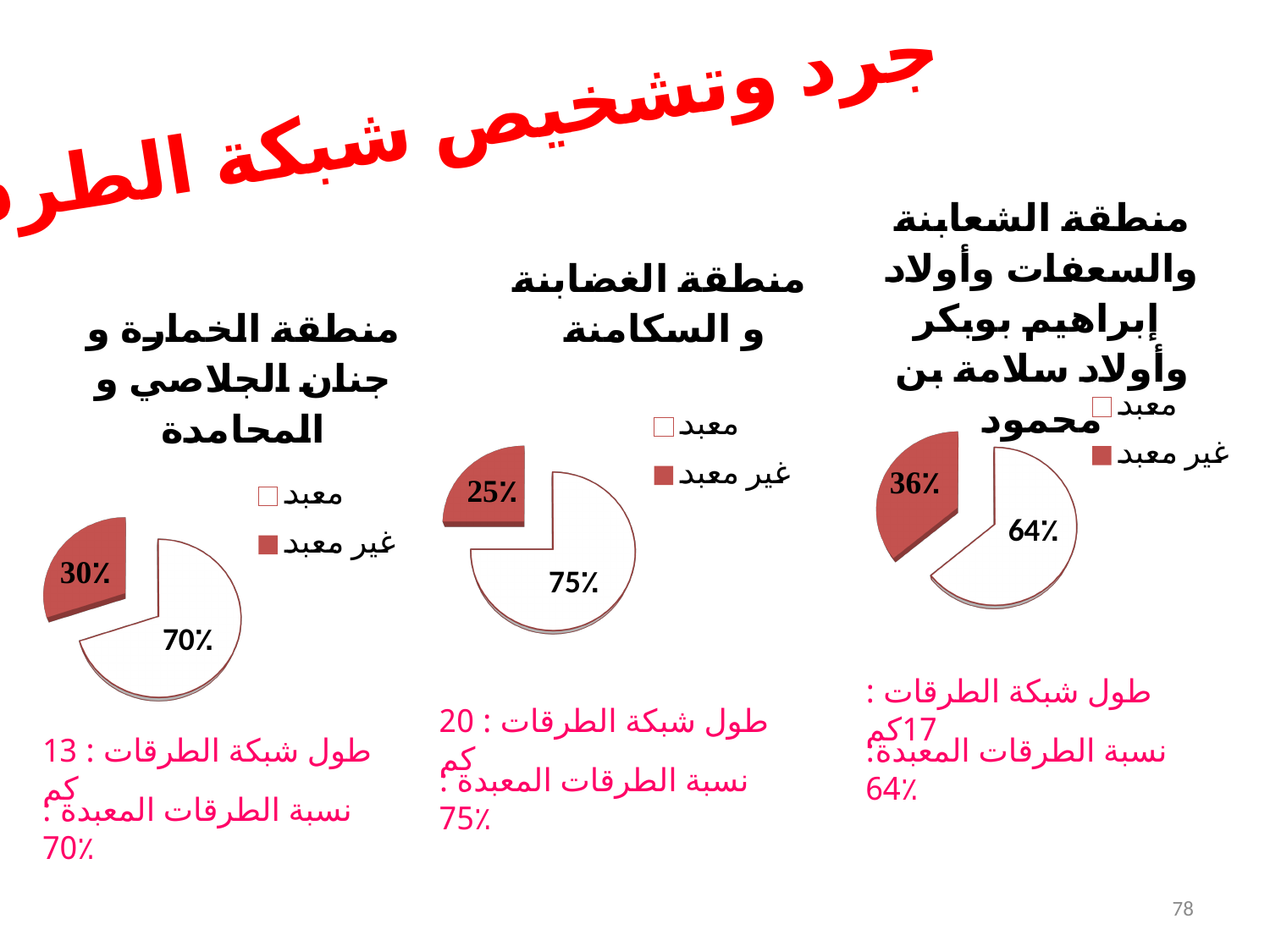
In the middle pie chart, which slice is larger, معبد or غير معبد? معبد What kind of chart is used for each of the three regions on the slide? Pie chart In the left-hand pie chart (منطقة الخمارة و جنان الجلاصي و المحامدة), what share is labelled غير معبد? 30% In the right-hand pie chart (منطقة الشعابنة والسعفات), what share is labelled معبد? 64% In the left-hand pie chart (منطقة الخمارة و جنان الجلاصي و المحامدة), what share is labelled معبد? 70% In the middle pie chart (منطقة الغضابنة و السكامنة), what share is labelled معبد? 75% In the right-hand pie chart, what is the difference between the معبد and غير معبد shares? 28% How many slices does the middle pie chart have? 2 In the middle pie chart (منطقة الغضابنة و السكامنة), what share is labelled غير معبد? 25% In the left-hand pie chart, which colour represents غير معبد? Red In the left-hand pie chart, what is the difference between the معبد and غير معبد shares? 40% In the right-hand pie chart (منطقة الشعابنة والسعفات), what share is labelled غير معبد? 36%